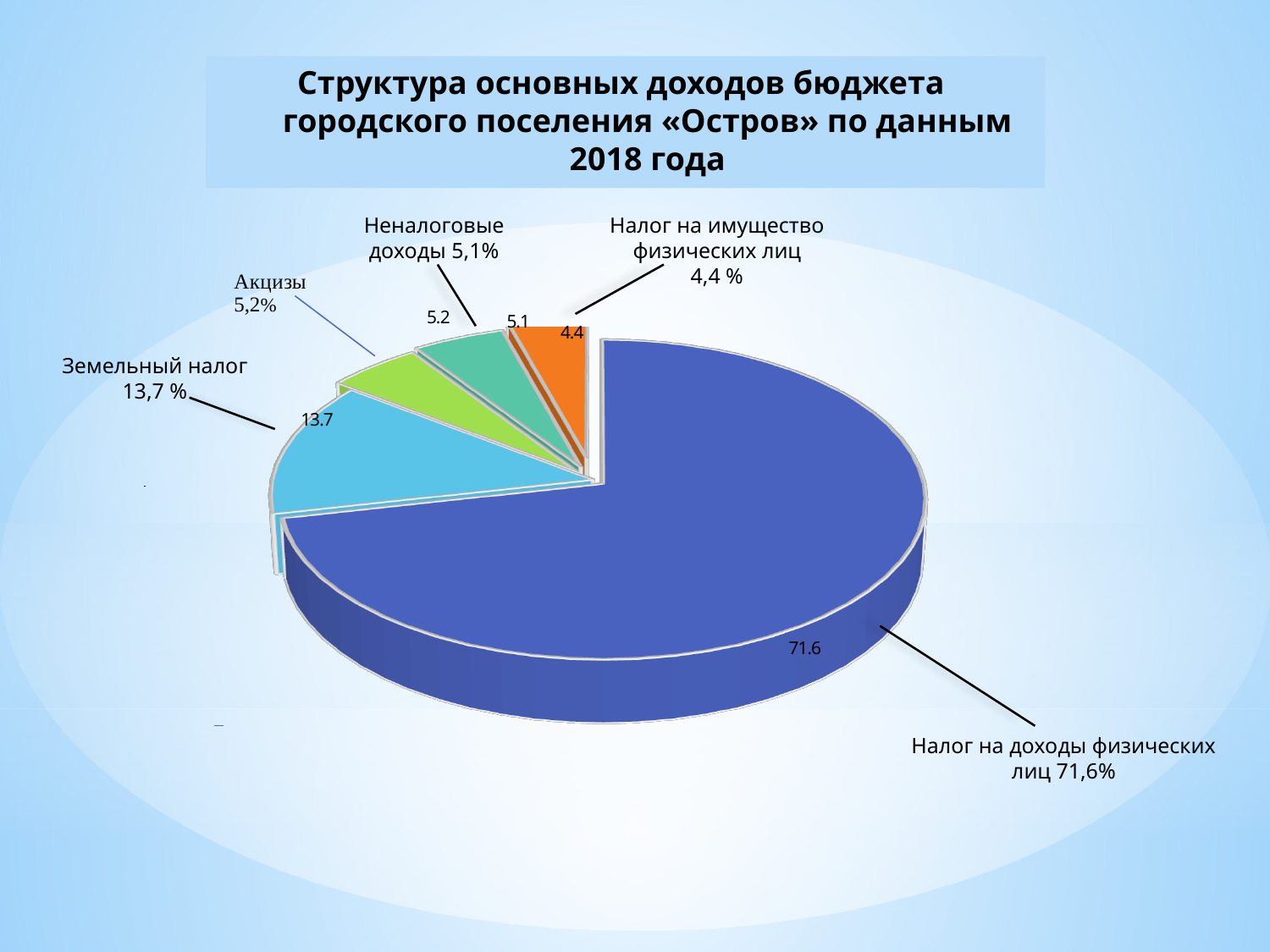
How many slices does the pie chart have? 5 Which is larger, the slice for Земельный налог or the slice for Акцизы? Земельный налог What is the value shown for Налог на доходы физических лиц? 71.6 What is the value shown for Налог на имущество физических лиц? 4.4 Which category has the largest slice of the pie? Налог на доходы физических лиц What is the value shown for Земельный налог? 13.7 Which category has the smallest slice of the pie? Налог на имущество физических лиц What kind of chart is shown on the slide? pie chart What is the value shown for Акцизы? 5.2 What year does the chart title say the data is from? 2018 What is the difference between the values for Налог на доходы физических лиц and Земельный налог? 57.9 What is the value shown for Неналоговые доходы? 5.1